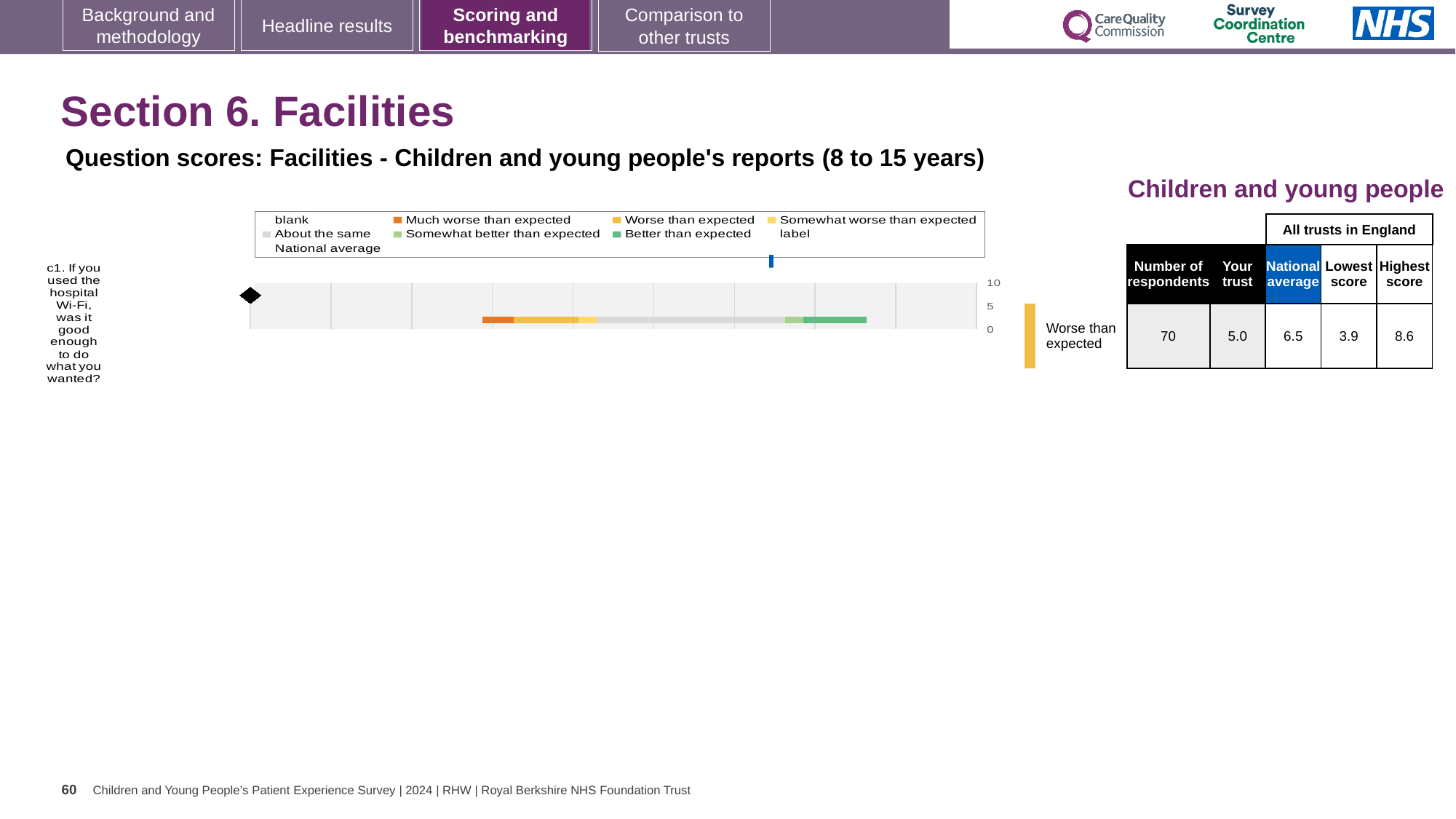
What rating category is assigned to question c1 on the slide? Worse than expected What is the highest tick value shown on the chart's axis? 10 What is the difference between the national average (6.5) and the trust's score (5.0) for question c1? 1.5 How many respondents answered question c1, according to the table beside the chart? 70 According to the table beside the chart, what is the lowest score among all trusts in England for question c1? 3.9 According to the table beside the chart, what is the 'Your trust' score for question c1? 5.0 Which is larger for question c1: the trust's score or the national average? national average According to the table beside the chart, what is the national average score for question c1? 6.5 What kind of chart is shown on the slide for question c1? bar chart How many survey questions are plotted in the chart? 1 Which colour does the legend use for 'Much worse than expected'? orange According to the table beside the chart, what is the highest score among all trusts in England for question c1? 8.6